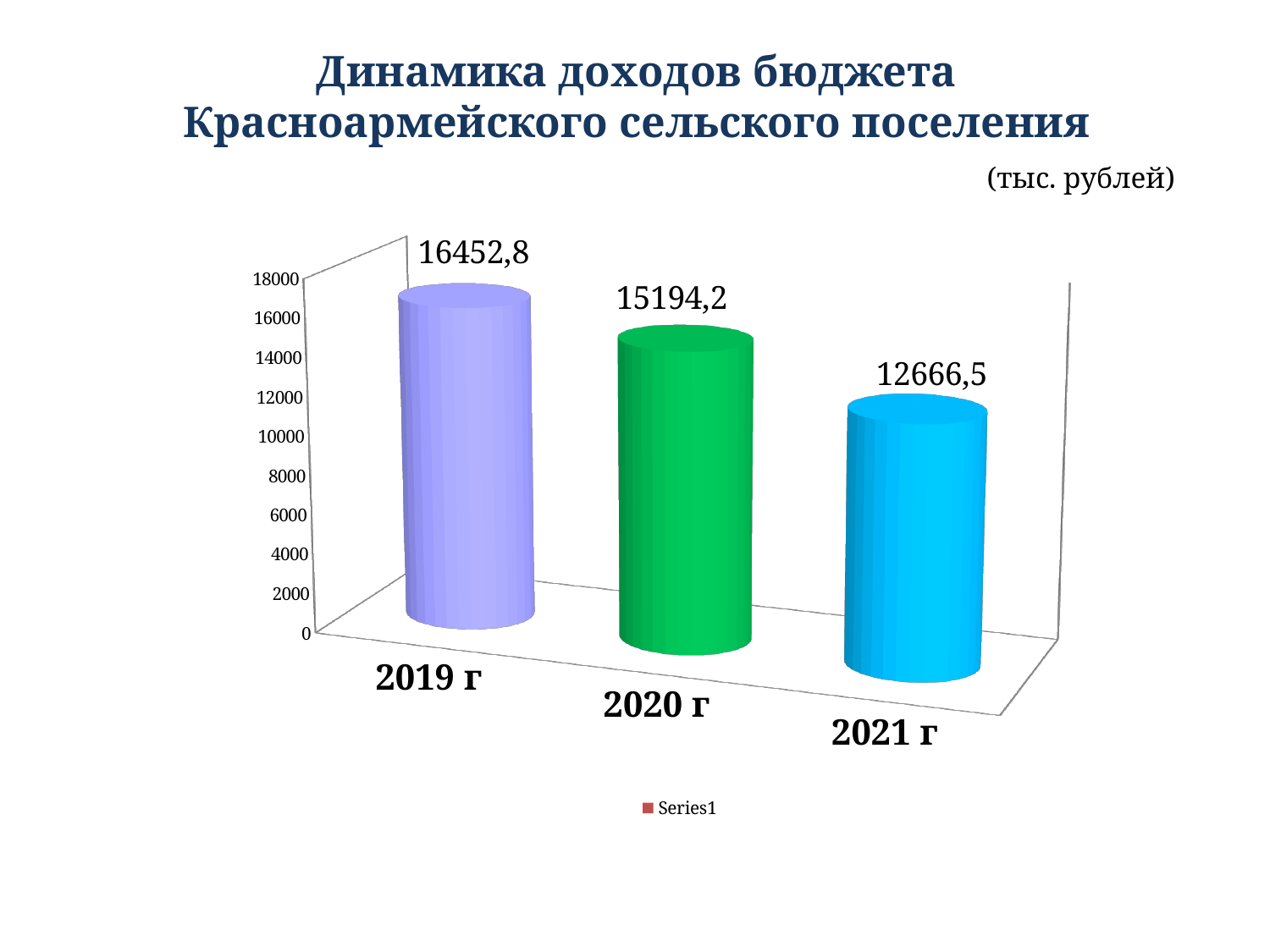
Which year has the highest value? 2019 г Which is larger, the value for 2020 г or the value for 2021 г? 2020 г What is the difference between the values for 2020 г and 2021 г? 2527,7 What is the value for 2019 г? 16452,8 Which year has the lowest value? 2021 г Do the values rise or fall from 2019 г to 2021 г? fall What is the difference between the values for 2019 г and 2020 г? 1258,6 What kind of chart is shown on the slide? bar chart How many years are shown on the chart? 3 What is the value for 2021 г? 12666,5 Is the value for 2021 г greater or less than 14000? less What is the value for 2020 г? 15194,2